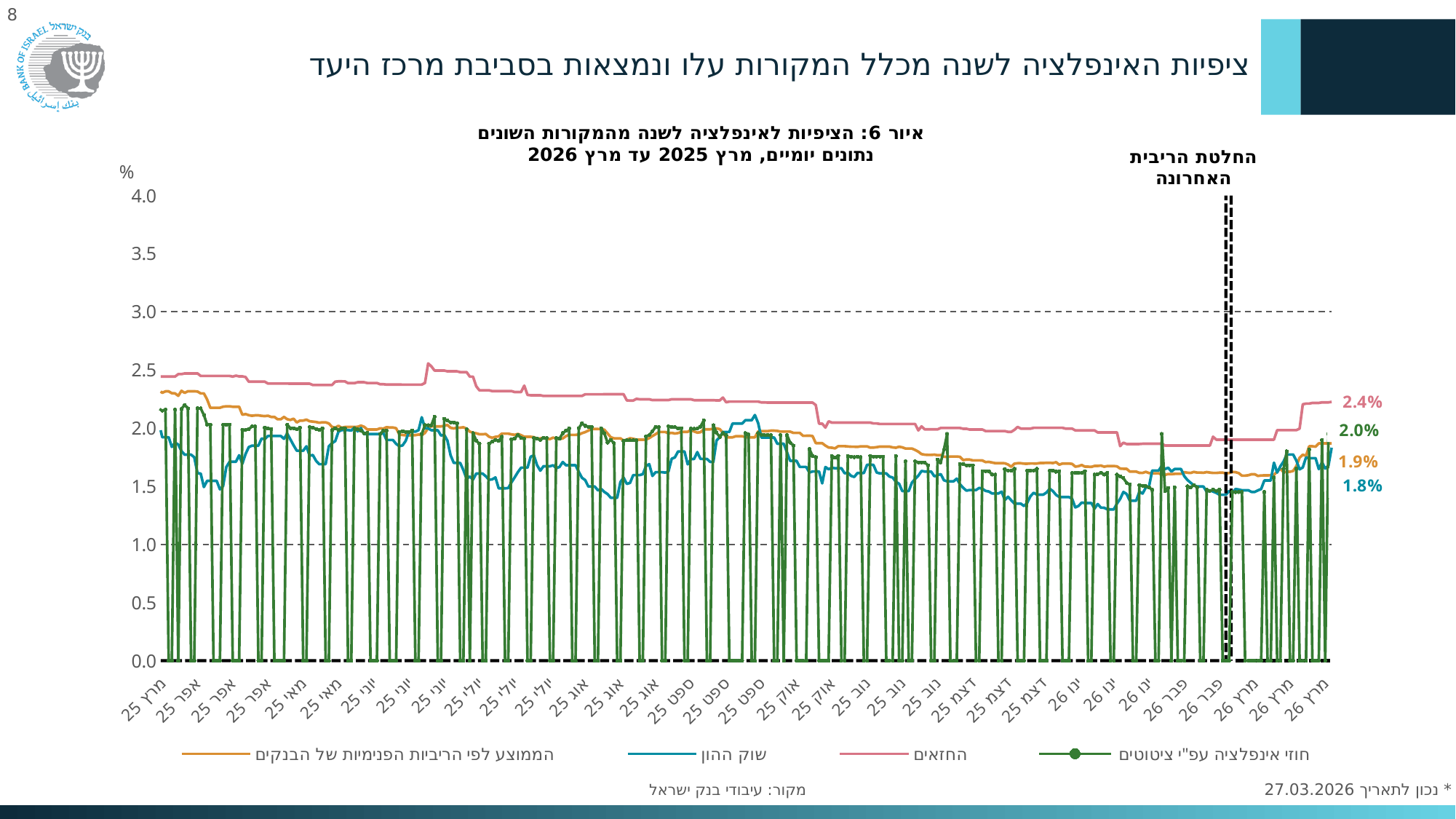
Does the החזאים (pink) line generally rise or fall from March 2025 to early 2026? fall What is the latest value labelled for the החזאים (forecasters) series? 2.4% What is the difference between the labelled end values of החזאים and שוק ההון? 0.6% What is the latest value labelled for the חוזי אינפלציה עפ"י ציטוטים series? 2.0% What is the latest value labelled for the הממוצע לפי הריביות הפנימיות של הבנקים series? 1.9% What type of chart is shown on the slide? line chart What event does the dashed vertical line near the right of the chart mark? החלטת הריבית האחרונה Which has a larger labelled end value, החזאים or הממוצע לפי הריביות הפנימיות של הבנקים? החזאים Which series has the highest labelled end value? החזאים What is the latest value labelled for the שוק ההון (capital market) series? 1.8% How many series does the legend list? 4 Which series has the lowest labelled end value? שוק ההון